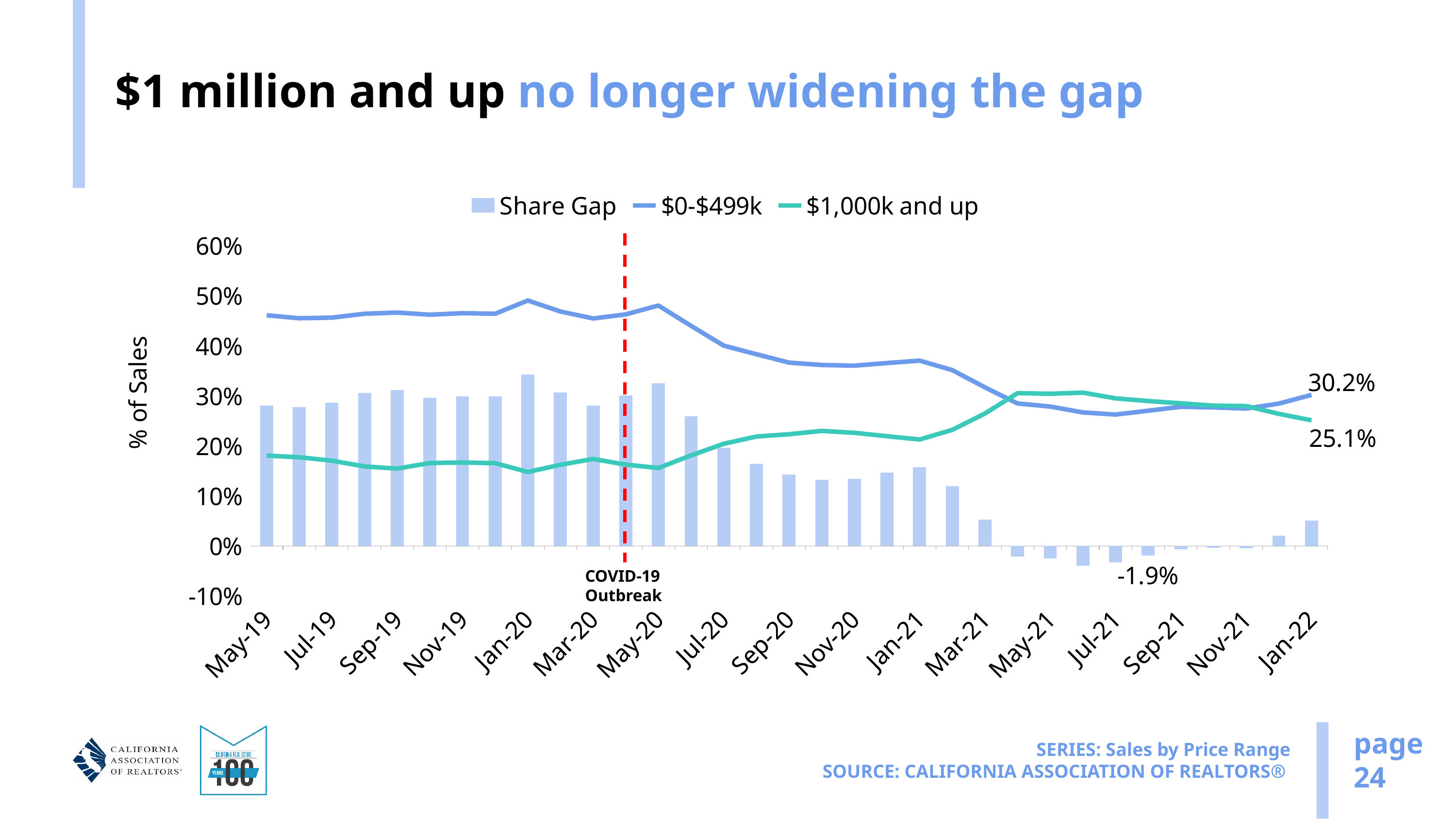
What is the lowest Share Gap value labeled on the chart? -1.9% In Jan-22, which is larger: the $0-$499k share or the $1,000k and up share? $0-$499k What event does the red dashed vertical line mark? COVID-19 Outbreak Is the $0-$499k value for May-19 greater or less than 40%? greater What is the value of the $1,000k and up series in Jan-22? 25.1% Is the Share Gap value for May-19 greater or less than 20%? greater Is the $1,000k and up value for May-19 greater or less than 30%? less What is the value of the $0-$499k series in Jan-22? 30.2% Does the $1,000k and up line generally rise or fall from May-19 to Jan-22? rise What kind of chart is this? Combination bar and line chart What is the difference between the $0-$499k and $1,000k and up values in Jan-22? 5.1 percentage points How many series does the legend list? 3